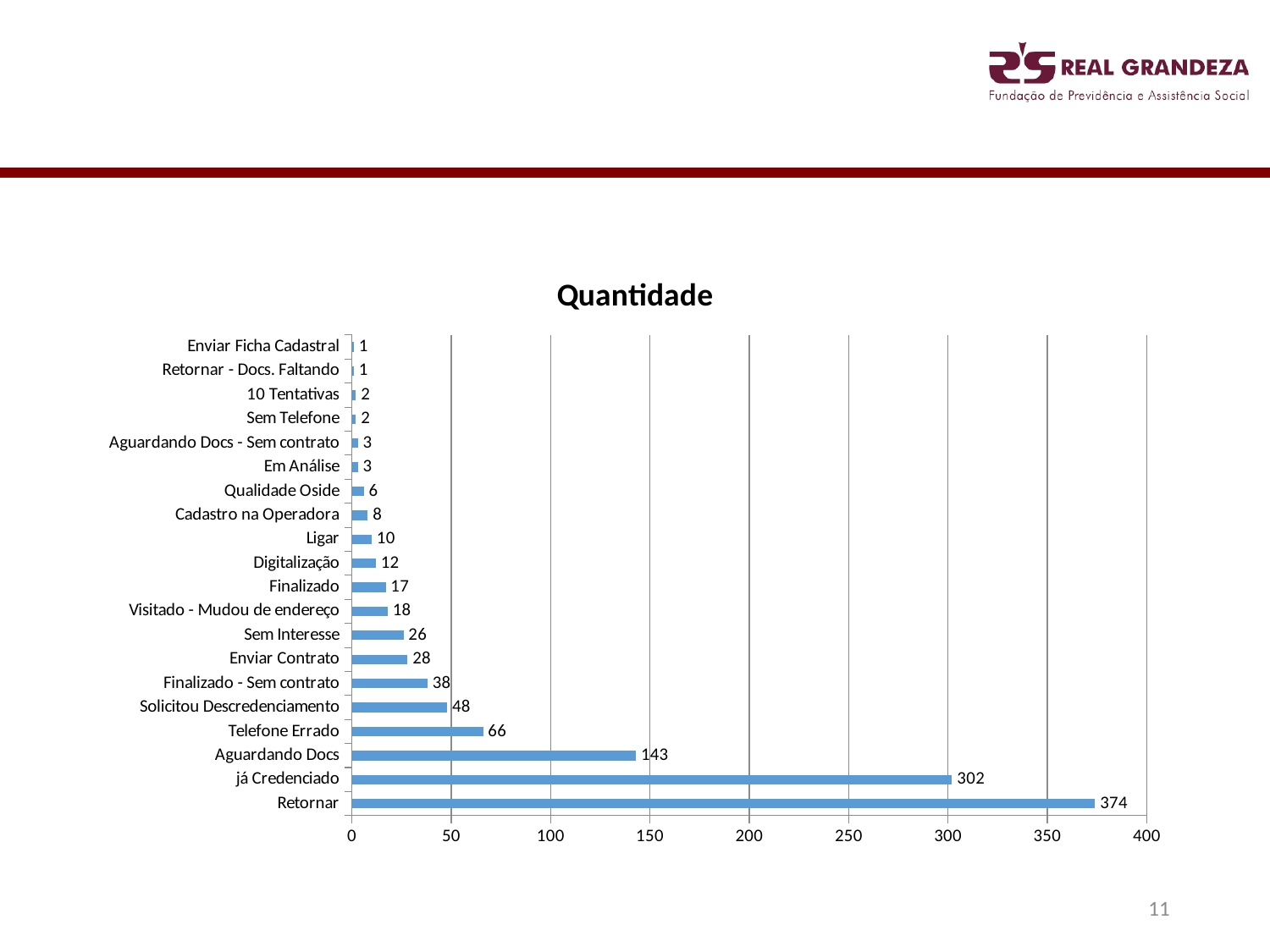
What is the value for Aguardando Docs? 143 Which category has the highest value? Retornar Is the value for já Credenciado greater or less than 300? greater Which is larger, the value for Finalizado - Sem contrato or the value for Enviar Contrato? Finalizado - Sem contrato What is the difference between the values for Retornar and já Credenciado? 72 What kind of chart is shown on the slide? Bar chart What is the difference between the values for Aguardando Docs and Telefone Errado? 77 What is the value for Retornar? 374 What is the title of the chart? Quantidade How many categories are shown in the chart? 20 What is the value for Telefone Errado? 66 What is the value for Sem Interesse? 26